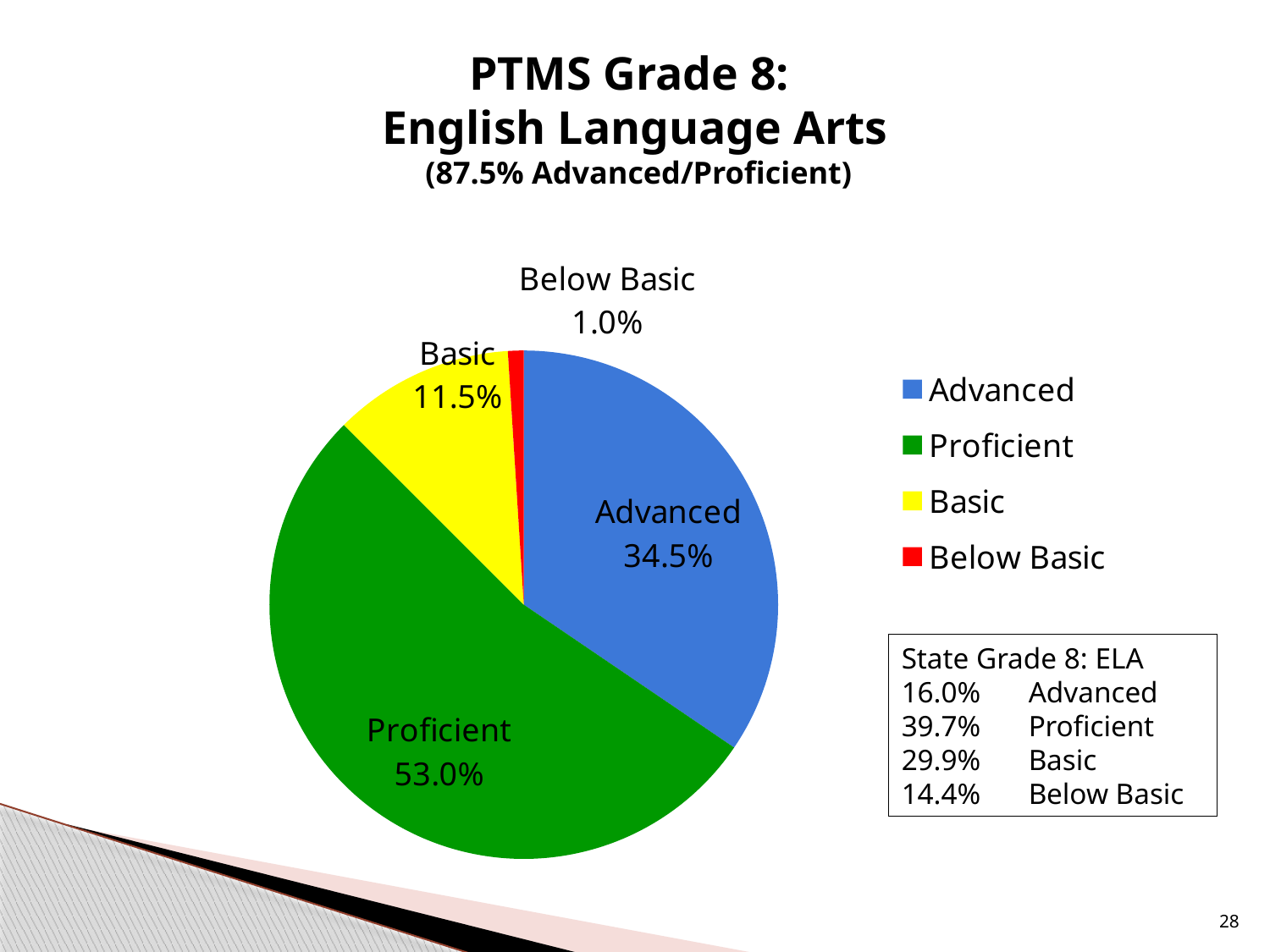
Which performance level has the smallest share of the pie? Below Basic What percentage of PTMS Grade 8 students scored Basic in English Language Arts? 11.5% What percentage of PTMS Grade 8 students scored Below Basic in English Language Arts? 1.0% Which slice is larger, Basic or Advanced? Advanced What percentage of PTMS Grade 8 students scored Proficient in English Language Arts? 53.0% How many performance levels are shown in the pie chart? 4 According to the title, what percentage of PTMS Grade 8 students scored Advanced or Proficient? 87.5% What colour represents the Proficient slice? Green What percentage of PTMS Grade 8 students scored Advanced in English Language Arts? 34.5% What type of chart is shown on the slide? Pie chart What is the difference in percentage points between the Proficient and Advanced slices? 18.5 Which performance level has the largest share of the pie? Proficient